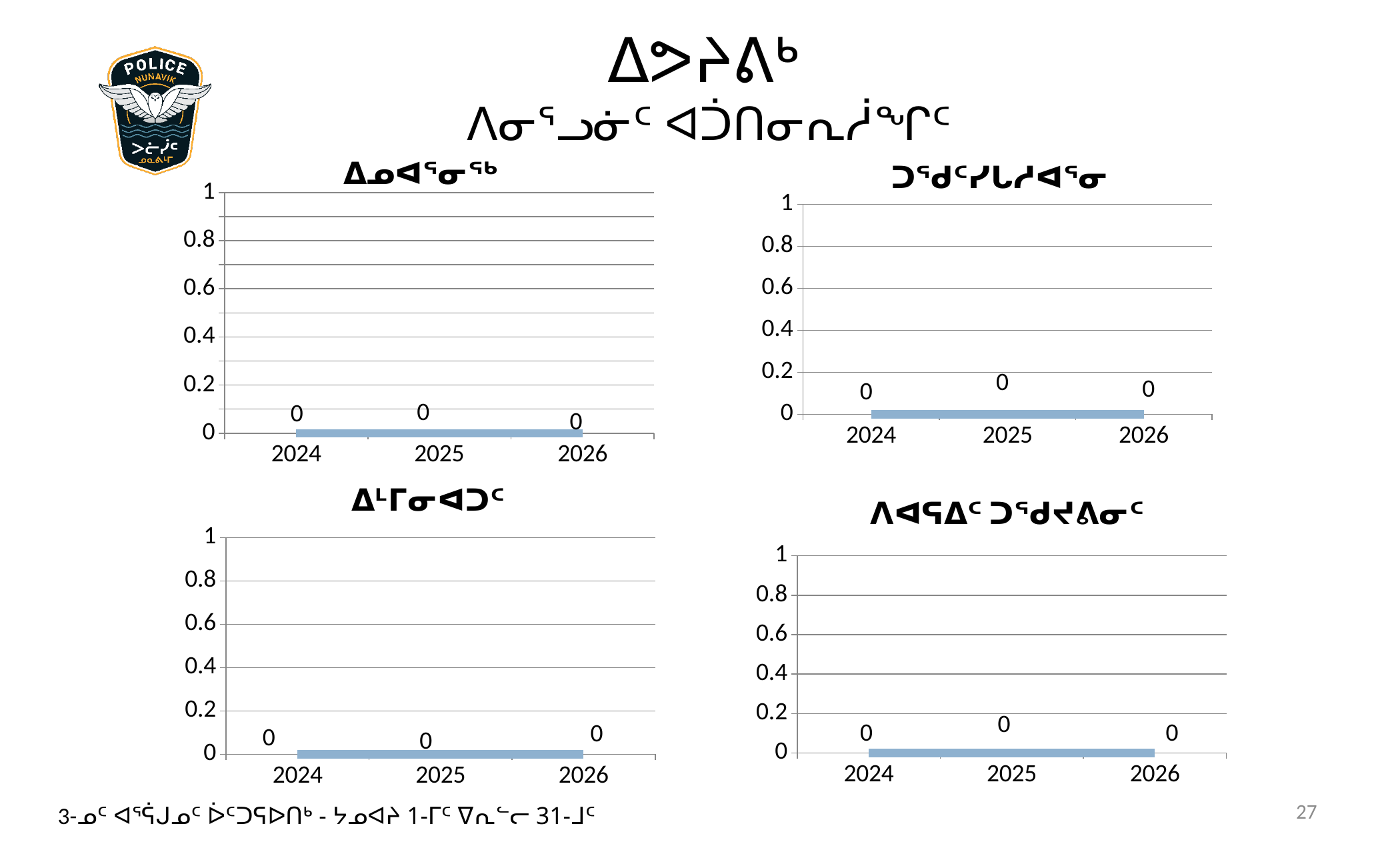
In the top-right chart, do the values rise, fall, or stay flat from 2024 to 2026? stay flat In the bottom-right chart, what is the value for 2024? 0 What kind of chart is the bottom-right chart? line chart In the top-left chart, is the value for 2025 greater or less than 0.2? less How many charts are on the slide? 4 What is the first year shown on the x axis of the bottom-left chart? 2024 What is the highest value shown on the y axis of the bottom-right chart? 1 In the top-left chart, what is the value for 2024? 0 How many years are shown on the x axis of the top-left chart? 3 In the bottom-left chart, what is the difference between the values for 2024 and 2026? 0 In the top-right chart, what is the value for 2025? 0 In the bottom-left chart, what is the value for 2026? 0